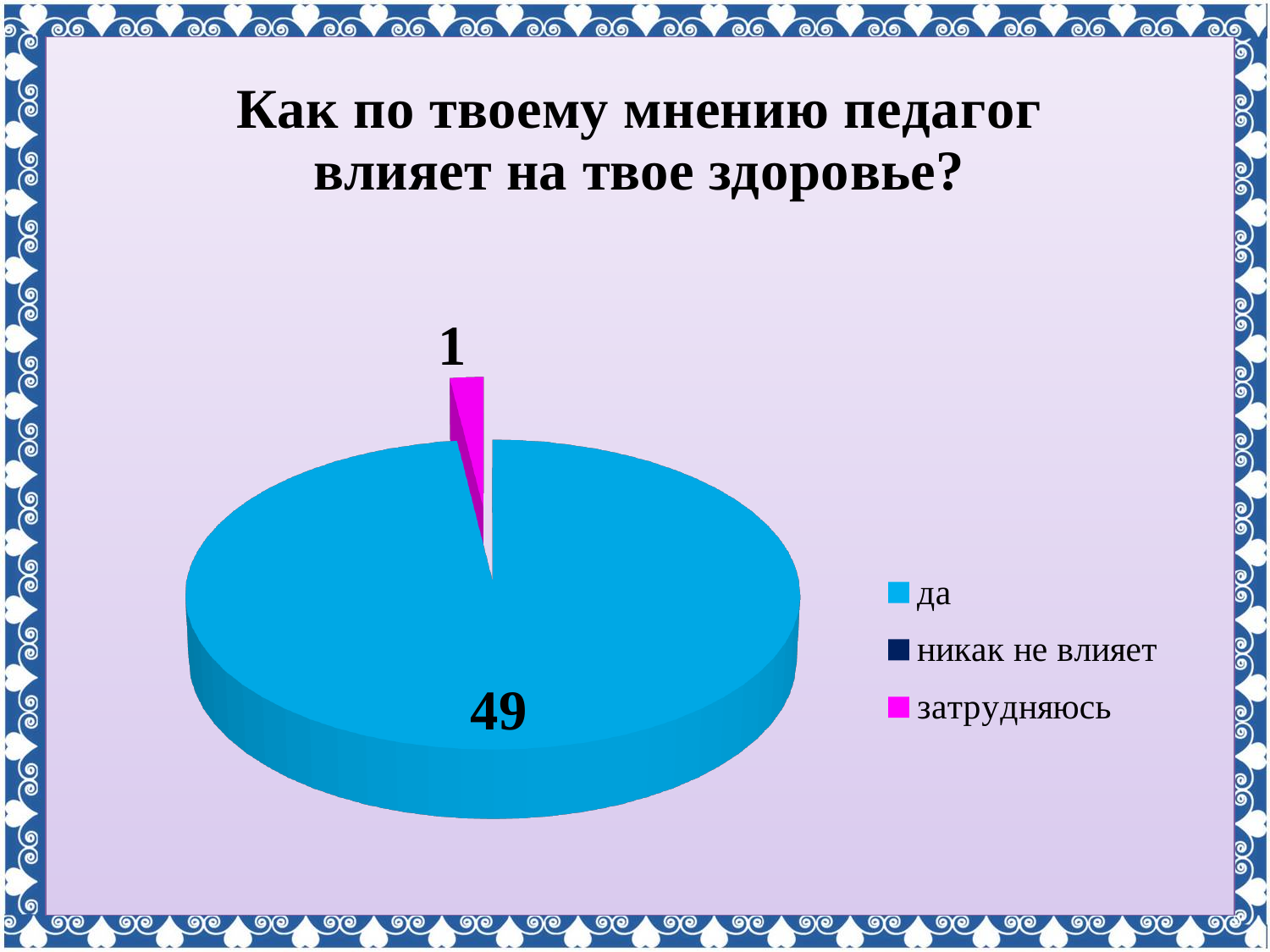
What is the value shown for the "затрудняюсь" slice? 1 Is the value for "да" greater or less than 40? greater What is the value shown for the "да" slice? 49 What colour is the "затрудняюсь" slice? magenta What is the difference between the value for "да" and the value for "затрудняюсь"? 48 What kind of chart is shown on the slide? pie chart What is the title of the chart? Как по твоему мнению педагог влияет на твое здоровье? How many categories does the legend list? 3 Which is larger, the value for "да" or the value for "затрудняюсь"? да Which category has the largest slice of the pie? да